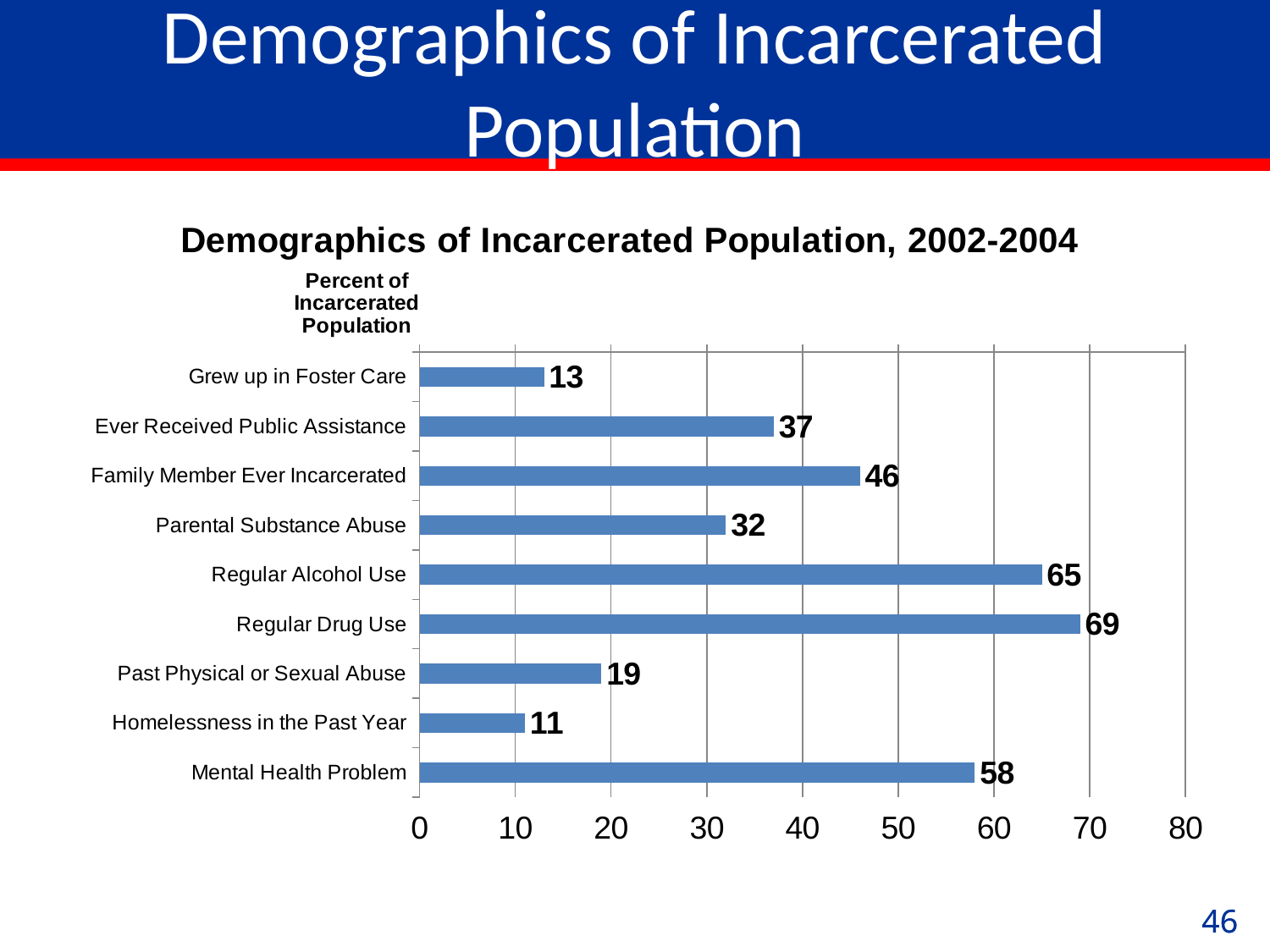
Which category has the lowest value? Homelessness in the Past Year Is the value for Past Physical or Sexual Abuse greater or less than 20? less Which category has the highest value? Regular Drug Use What kind of chart is shown on the slide? bar chart What is the value for Regular Drug Use? 69 What is the label of the value axis? Percent of Incarcerated Population What is the value for Grew up in Foster Care? 13 What is the value for Mental Health Problem? 58 What is the difference between Regular Alcohol Use and Parental Substance Abuse? 33 How many categories are shown in the chart? 9 What is the title of the chart? Demographics of Incarcerated Population, 2002-2004 Which is larger, Ever Received Public Assistance or Family Member Ever Incarcerated? Family Member Ever Incarcerated